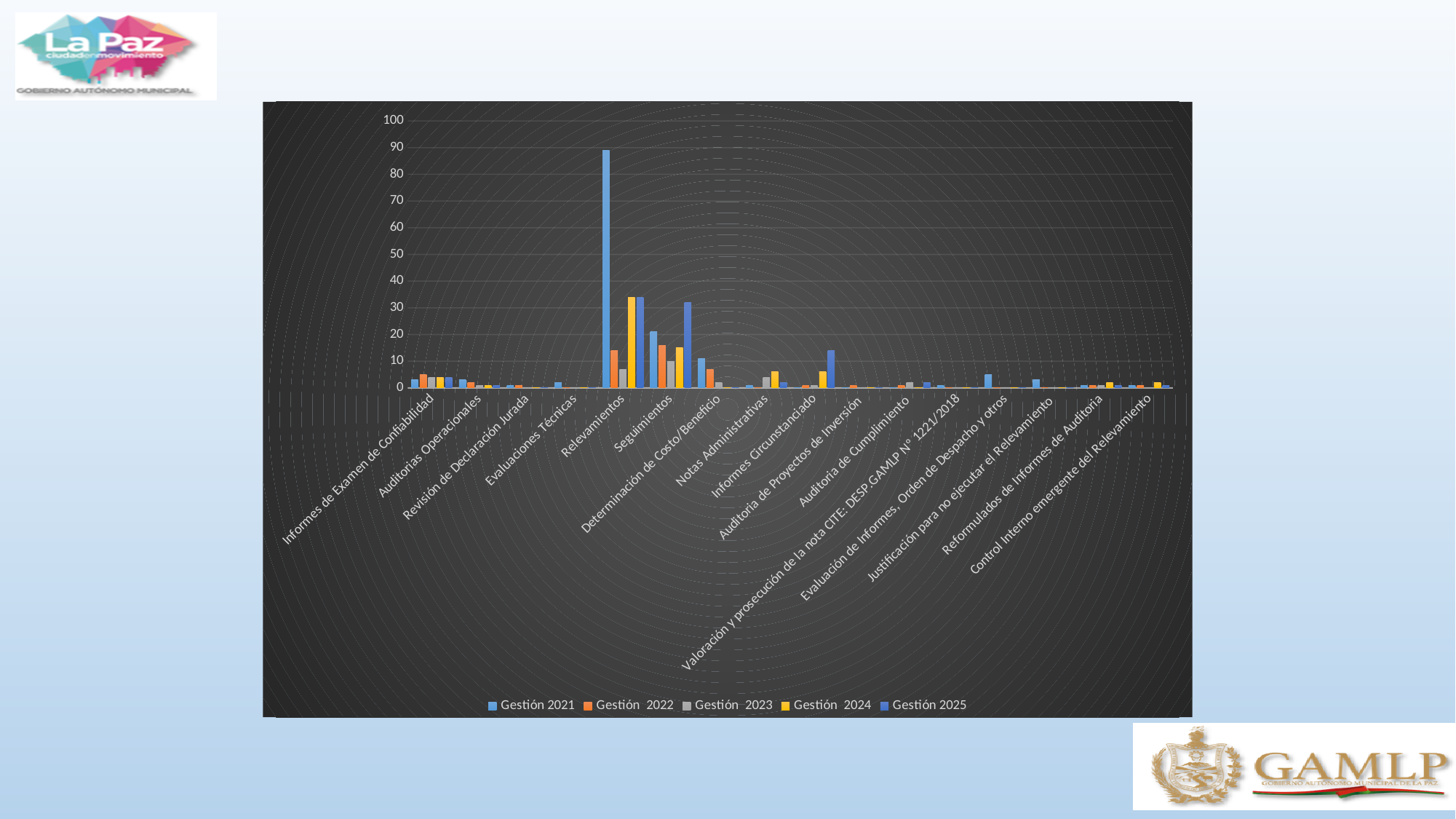
Which series has the highest value for Relevamientos? Gestión 2021 Which category has the tallest bar in the chart? Relevamientos What colour represents Gestión 2024 in the legend? yellow Is the value for Relevamientos in Gestión 2021 greater or less than 80? greater Is the value for Determinación de Costo/Beneficio in Gestión 2025 greater or less than 20? less How many series does the legend list? 5 Which is larger for Gestión 2021: Relevamientos or Seguimientos? Relevamientos How many categories are shown along the x axis? 16 Is the value for Relevamientos in Gestión 2024 greater or less than 30? greater What kind of chart is shown on the slide? bar chart Which is larger for Gestión 2022: Relevamientos or Auditorías Operacionales? Relevamientos